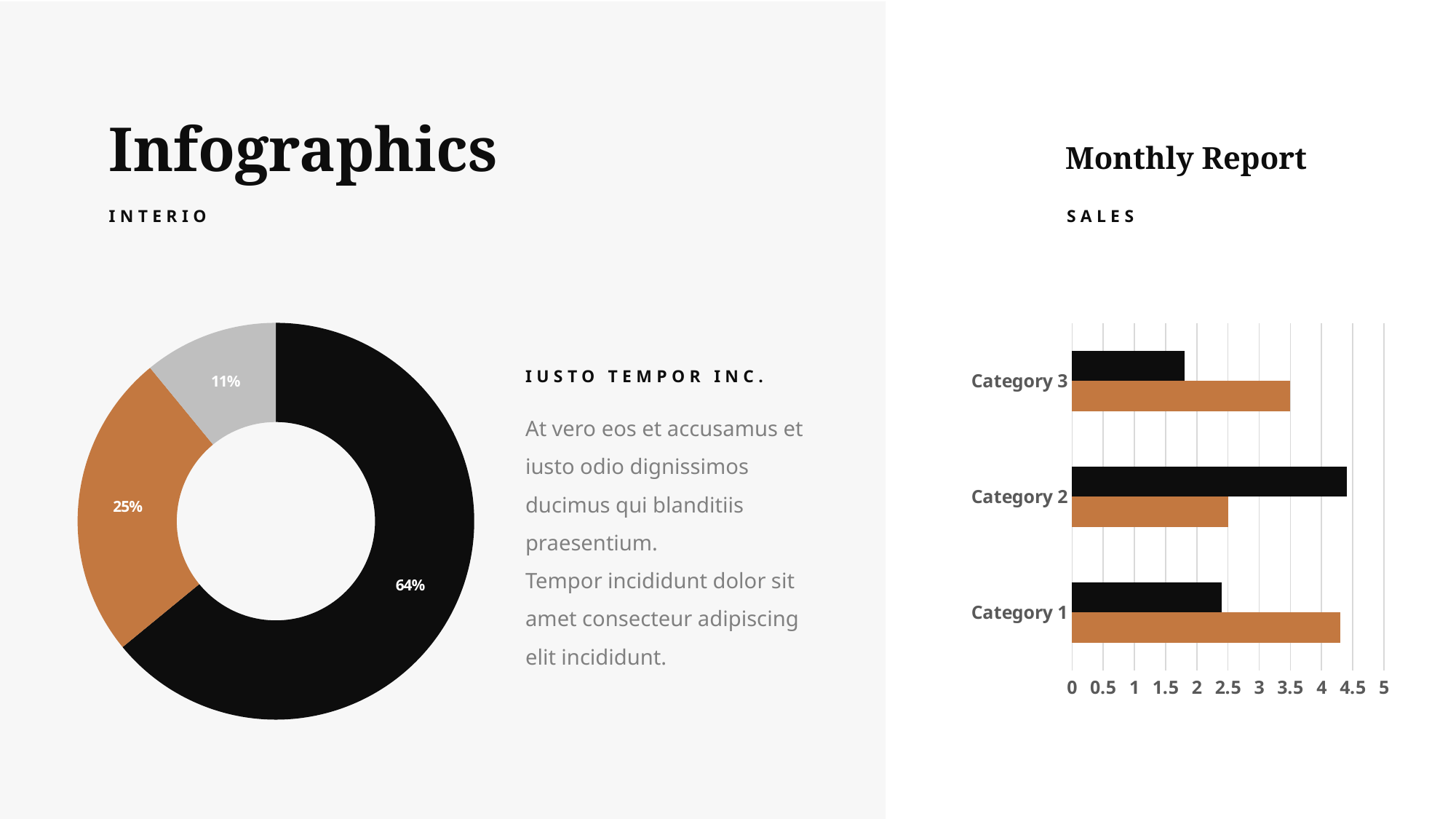
In the Monthly Report chart, is the black bar for Category 3 greater or less than 2? less In the doughnut chart on the left, what percentage is shown on the orange slice? 25% In the doughnut chart on the left, how many slices are there? 3 In the doughnut chart on the left, what percentage is shown on the grey slice? 11% In the doughnut chart on the left, what percentage is shown on the black slice? 64% What kind of chart is the chart on the left of the slide? doughnut chart In the Monthly Report chart, which category has the longest black bar? Category 2 In the Monthly Report chart, how many categories are shown on the vertical axis? 3 In the doughnut chart on the left, what is the difference in percentage points between the largest slice and the smallest slice? 53 In the Monthly Report chart, for Category 1, which bar is longer, the black bar or the orange bar? the orange bar What kind of chart is the Monthly Report chart on the right? bar chart In the Monthly Report chart, which category has the longest orange bar? Category 1